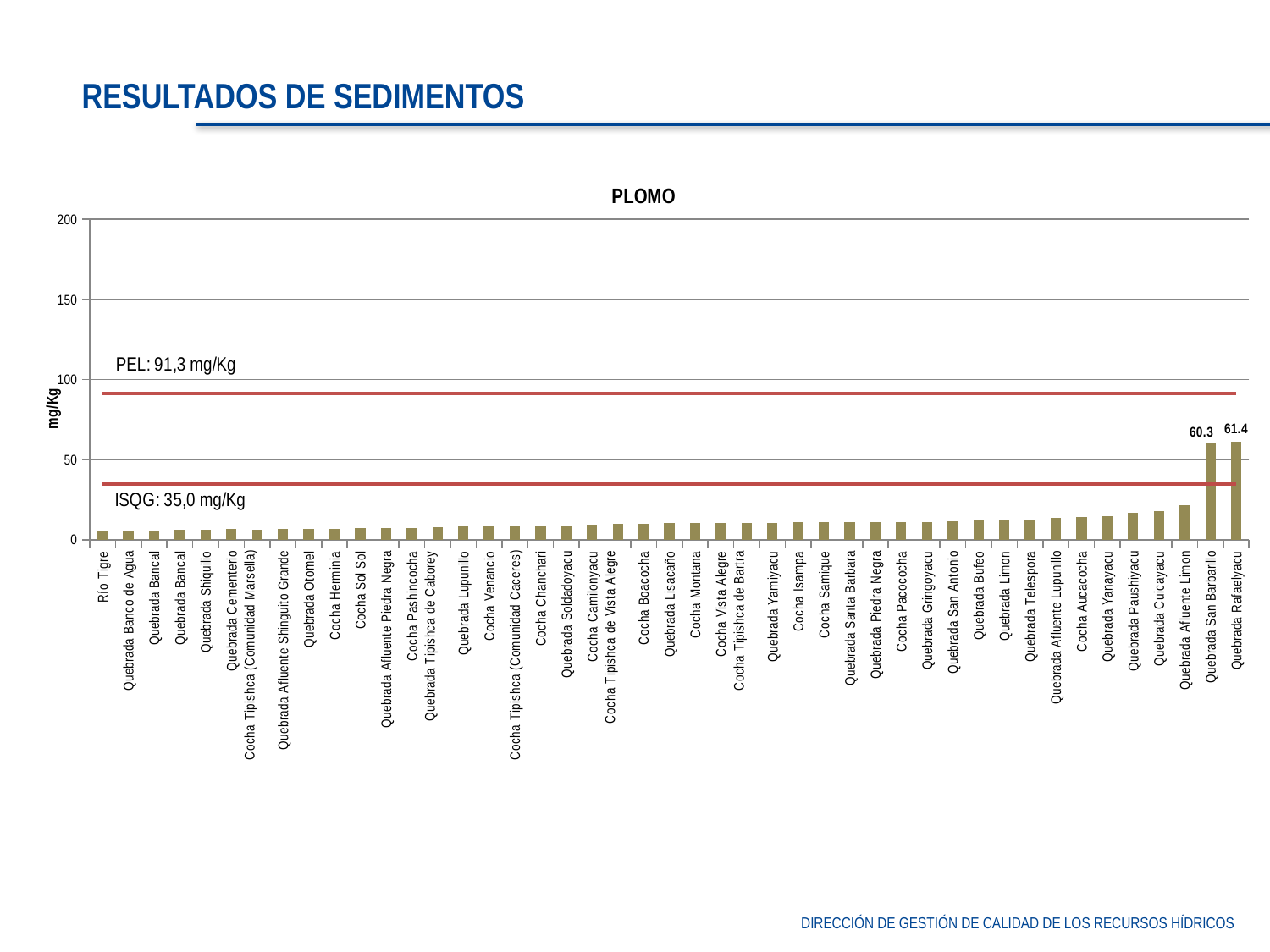
What is the title of the chart? PLOMO Do the values generally rise or fall from left to right along the x axis? rise What is the value for Quebrada San Barbarillo? 60.3 Is the value for Quebrada Afluente Limon greater or less than 50? less What value is given for the PEL reference line on the chart? 91,3 mg/Kg Is the value for Río Tigre greater or less than 50? less Which category has the highest value? Quebrada Rafaelyacu What is the difference between the values for Quebrada Rafaelyacu and Quebrada San Barbarillo? 1.1 What is the value for Quebrada Rafaelyacu? 61.4 Which is larger, the value for Quebrada San Barbarillo or the value for Quebrada Rafaelyacu? Quebrada Rafaelyacu Is the value for Quebrada Rafaelyacu greater or less than 50? greater What kind of chart is shown on the slide? bar chart